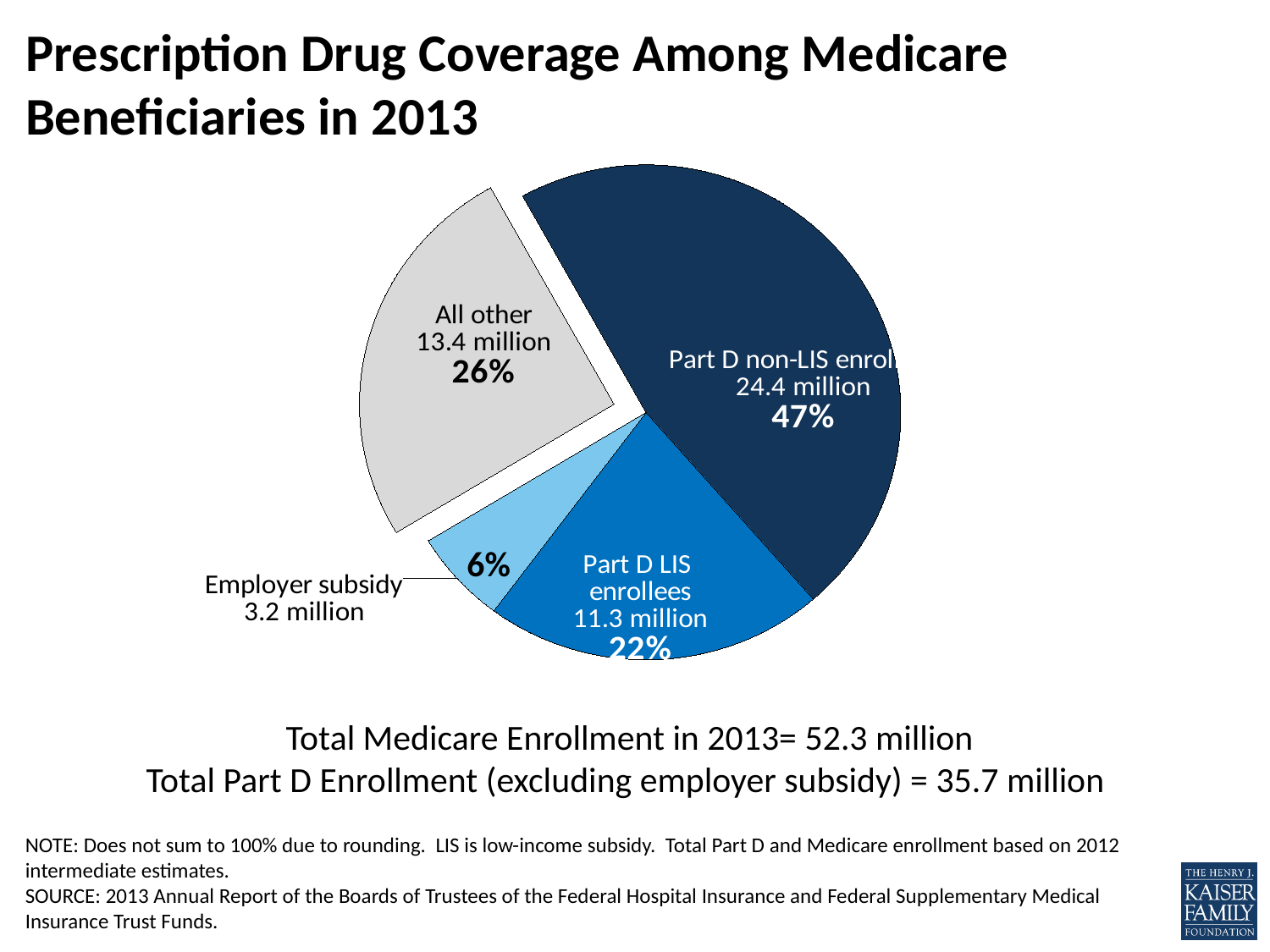
What kind of chart is shown on the slide? Pie chart What is the difference in millions between Part D non-LIS enrollees and Part D LIS enrollees? 13.1 million What is the title of the chart on the slide? Prescription Drug Coverage Among Medicare Beneficiaries in 2013 What share of Medicare beneficiaries are Part D non-LIS enrollees? 47% Which is larger, the All other slice or the Part D LIS enrollees slice? All other How many Medicare beneficiaries are in the Employer subsidy group? 3.2 million Which slice of the pie chart is the largest? Part D non-LIS enrollees How many Medicare beneficiaries are Part D LIS enrollees? 11.3 million How many slices does the pie chart have? 4 What share of the pie is the All other slice? 26% What is the difference in percentage points between the All other slice and the Employer subsidy slice? 20 percentage points Which slice of the pie chart is the smallest? Employer subsidy